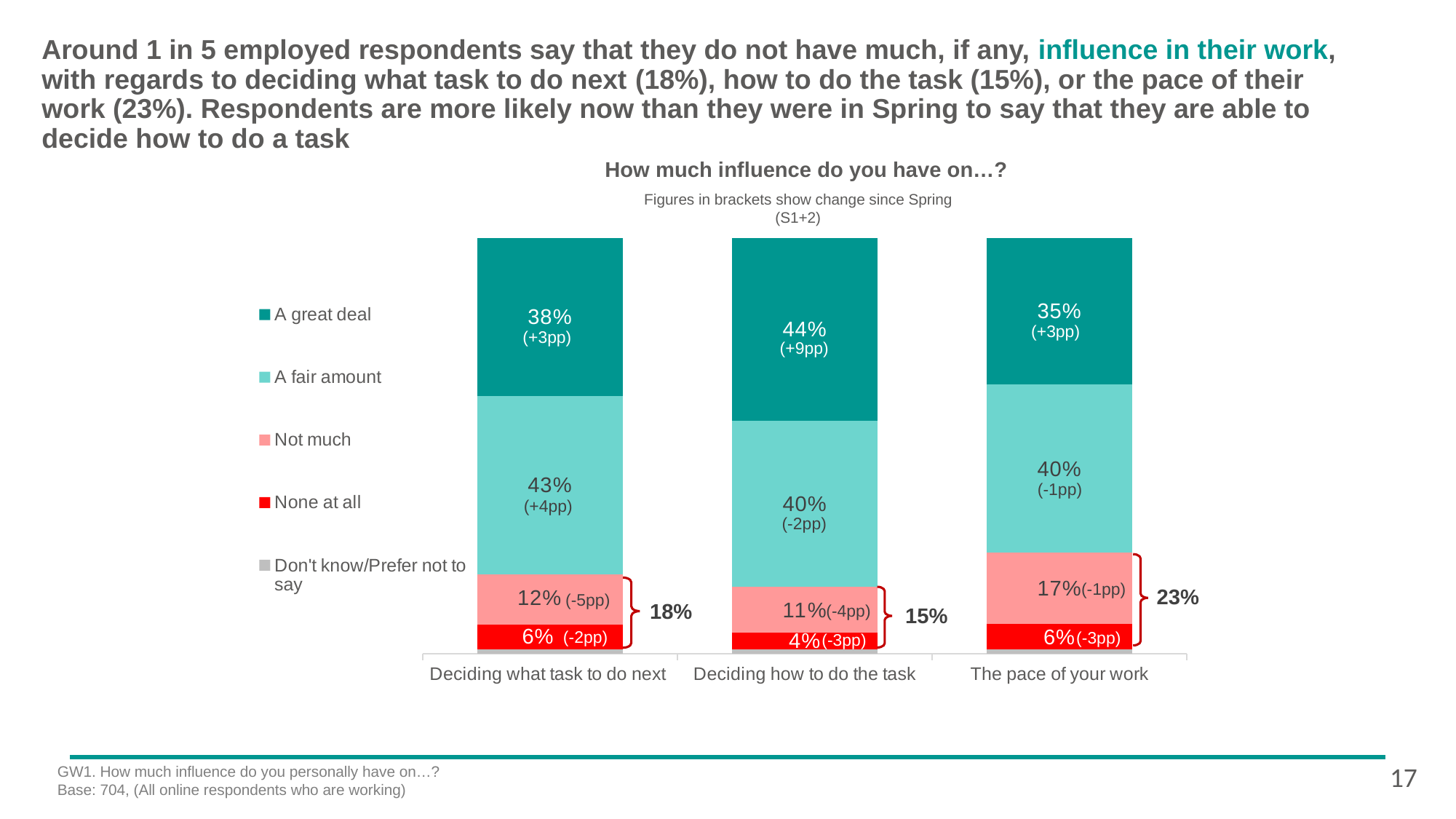
Which has a larger 'A great deal' value: 'Deciding what task to do next' or 'The pace of your work'? Deciding what task to do next How many categories are shown on the x axis of the chart? 3 What percentage of respondents say they have 'Not much' influence on the pace of their work? 17% What percentage of respondents say they have 'None at all' influence on deciding how to do the task? 4% Which category has the highest 'A great deal' value? Deciding how to do the task Which category has the lowest 'None at all' value? Deciding how to do the task What is the difference between the 'A fair amount' values for 'Deciding what task to do next' and 'The pace of your work'? 3 percentage points What percentage of respondents say they have 'A great deal' of influence on deciding how to do the task? 44% How many series does the legend list? 5 What kind of chart is shown on the slide? Stacked bar chart What is the change since Spring shown for 'A great deal' in the 'Deciding how to do the task' bar? +9pp What combined percentage is shown by the bracket for 'Not much' and 'None at all' on 'The pace of your work'? 23%